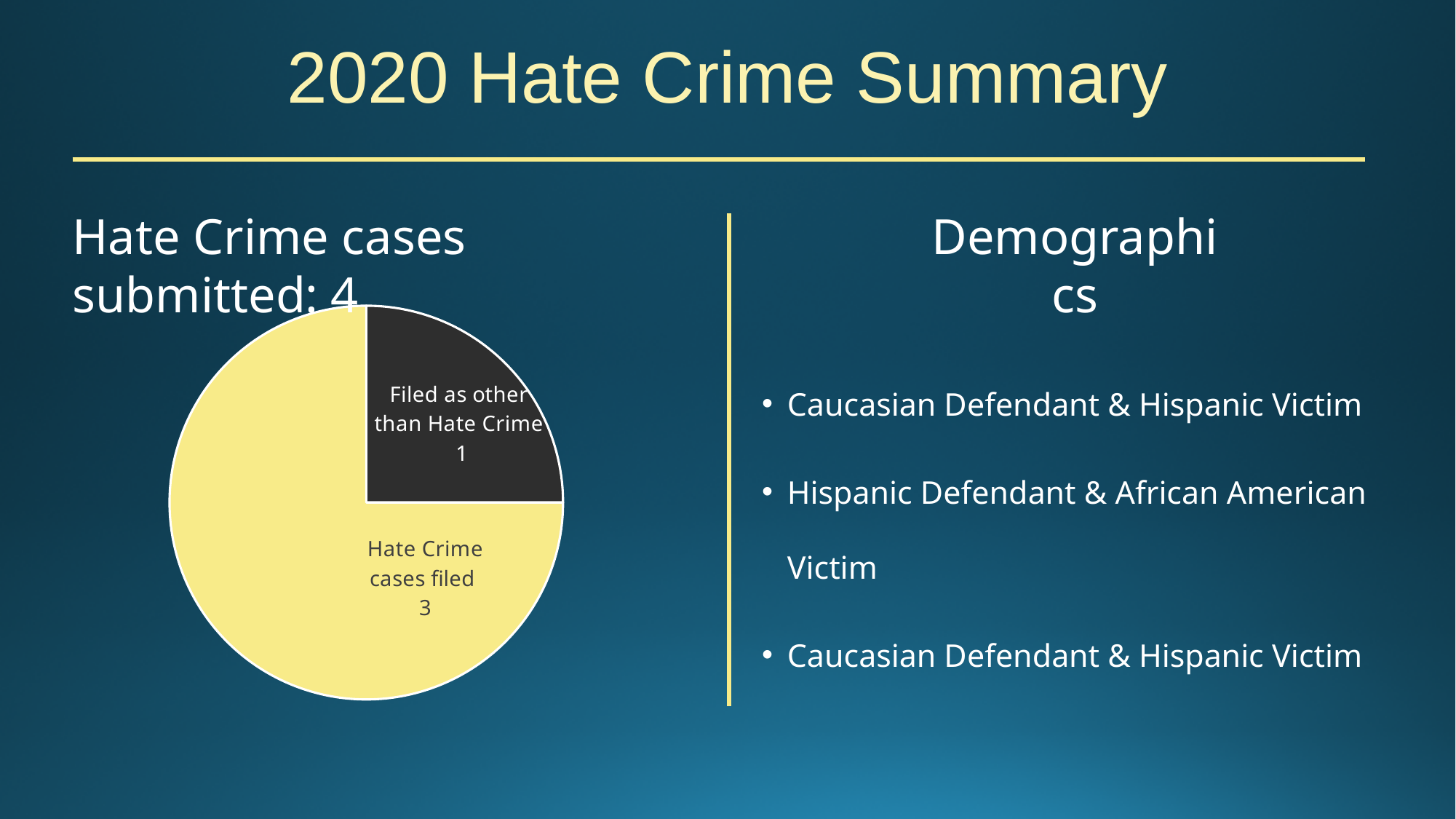
What is the value for Filed as other than Hate Crime? 1 Which is larger: Hate Crime cases filed or Filed as other than Hate Crime? Hate Crime cases filed Which slice of the pie chart is the largest? Hate Crime cases filed What kind of chart is shown on the slide? pie chart What is the total of all slices in the pie chart? 4 What share of the pie does Hate Crime cases filed represent? 75% How many slices does the pie chart have? 2 What share of the pie does Filed as other than Hate Crime represent? 25% What colour is the Hate Crime cases filed slice? yellow Which slice of the pie chart is the smallest? Filed as other than Hate Crime What is the difference between Hate Crime cases filed and Filed as other than Hate Crime? 2 What is the value for Hate Crime cases filed? 3